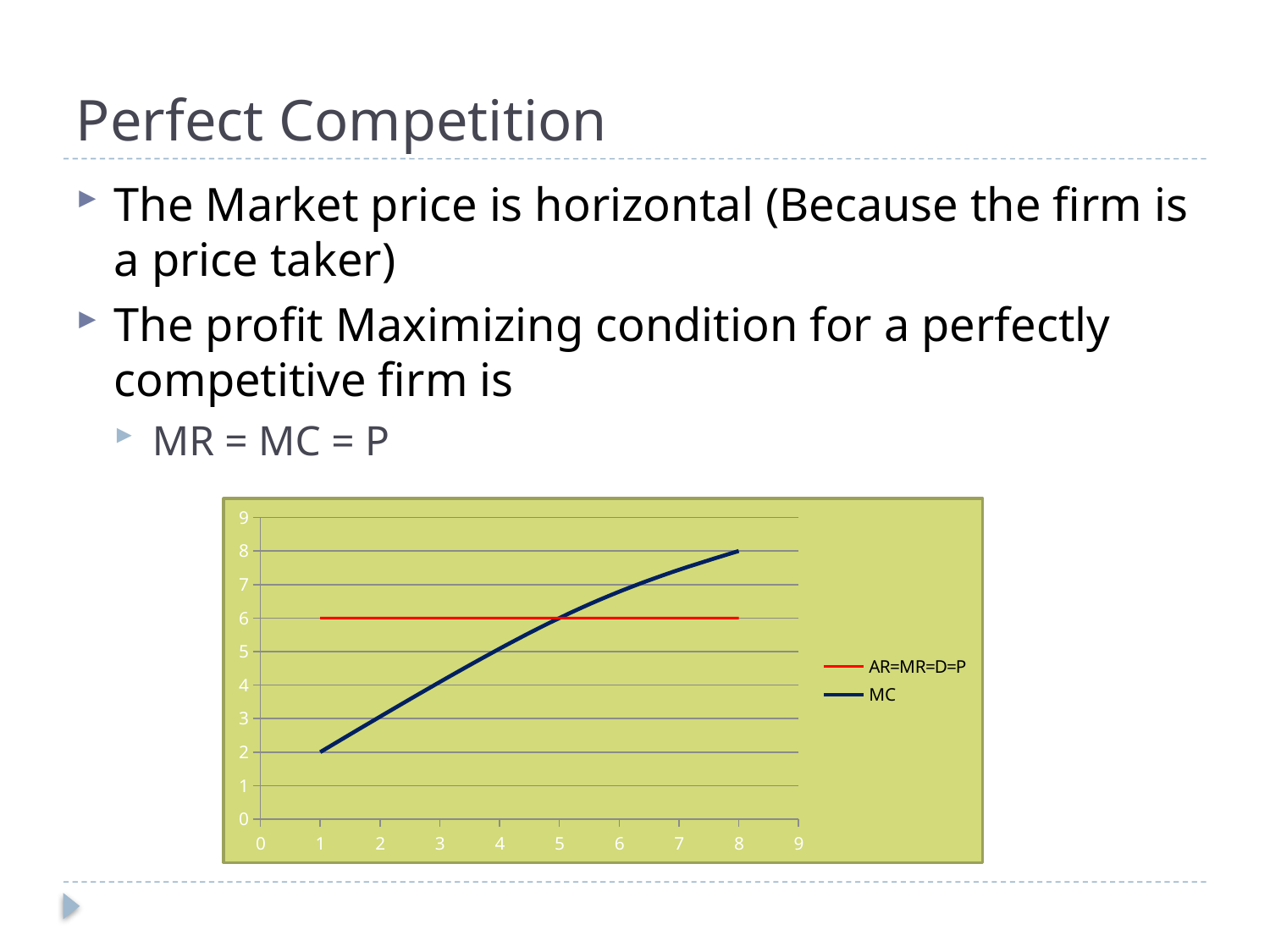
At x = 2, which series has the higher value, MC or AR=MR=D=P? AR=MR=D=P How many series does the chart's legend list? 2 Does the AR=MR=D=P line rise, fall, or stay flat as x increases? stays flat Does the MC curve rise or fall as x increases? rises By how much does the MC curve increase from x = 1 to x = 8? 6 What is the value of the MC curve at x = 1? 2 What are the two series named in the chart's legend? AR=MR=D=P and MC At what value on the vertical axis does the horizontal AR=MR=D=P line sit? 6 Is the value of the MC curve at x = 3 greater or less than 5? less What is the value of the MC curve at x = 8? 8 What kind of chart is shown on the slide? line chart Is the value of the MC curve at x = 7 greater or less than 6? greater